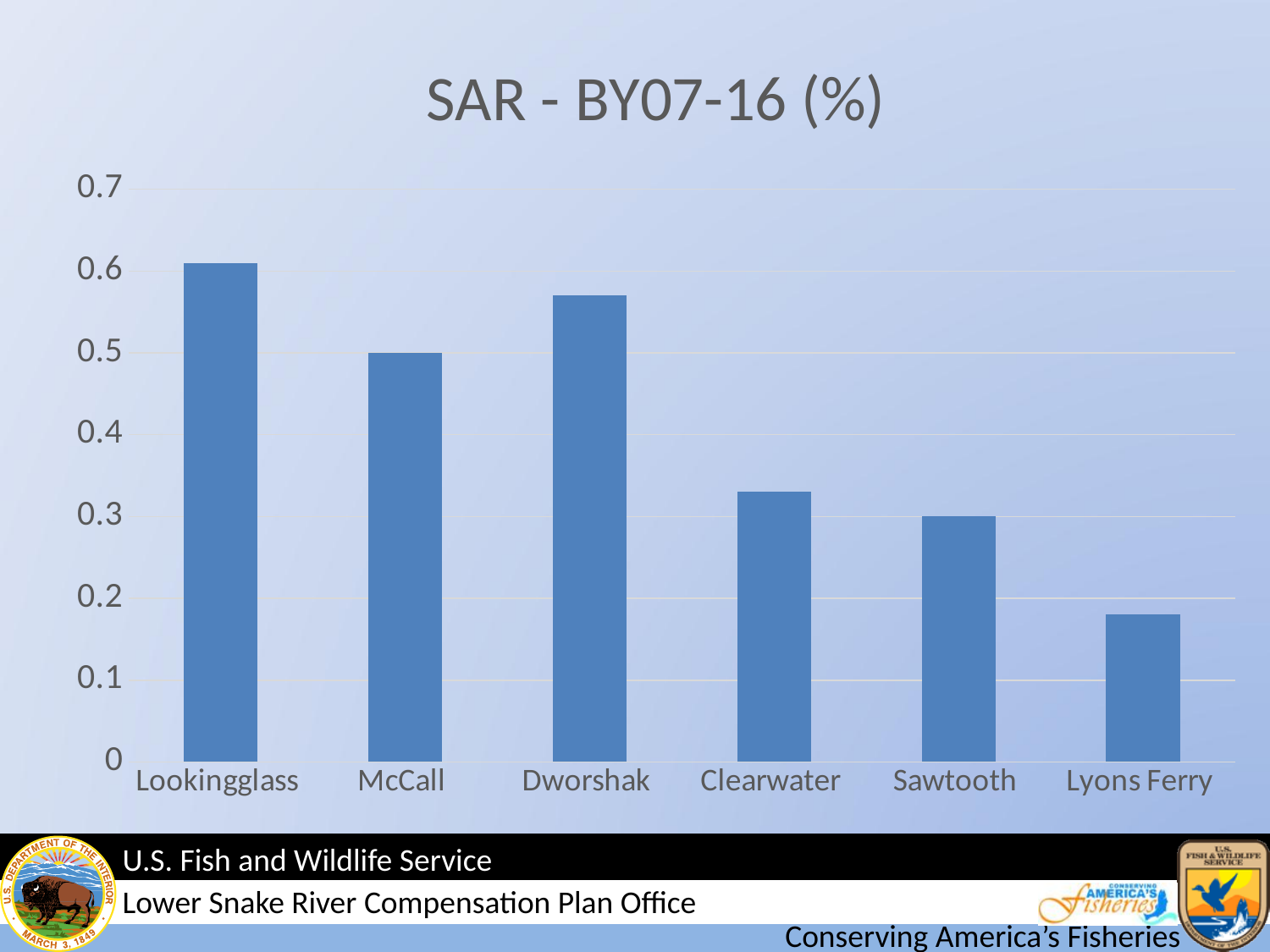
What is the title of the chart? SAR - BY07-16 (%) Is the value for Lyons Ferry greater or less than 0.2? less What kind of chart is shown on the slide? bar chart How many categories are plotted on the x axis of the chart? 6 Which has the larger value, Lookingglass or Dworshak? Lookingglass Which category has the highest value in the chart? Lookingglass Is the value for Clearwater greater or less than 0.3? greater What is the value for McCall? 0.5 Is the value for Dworshak greater or less than 0.5? greater Which category has the lowest value in the chart? Lyons Ferry Which has the larger value, Dworshak or McCall? Dworshak